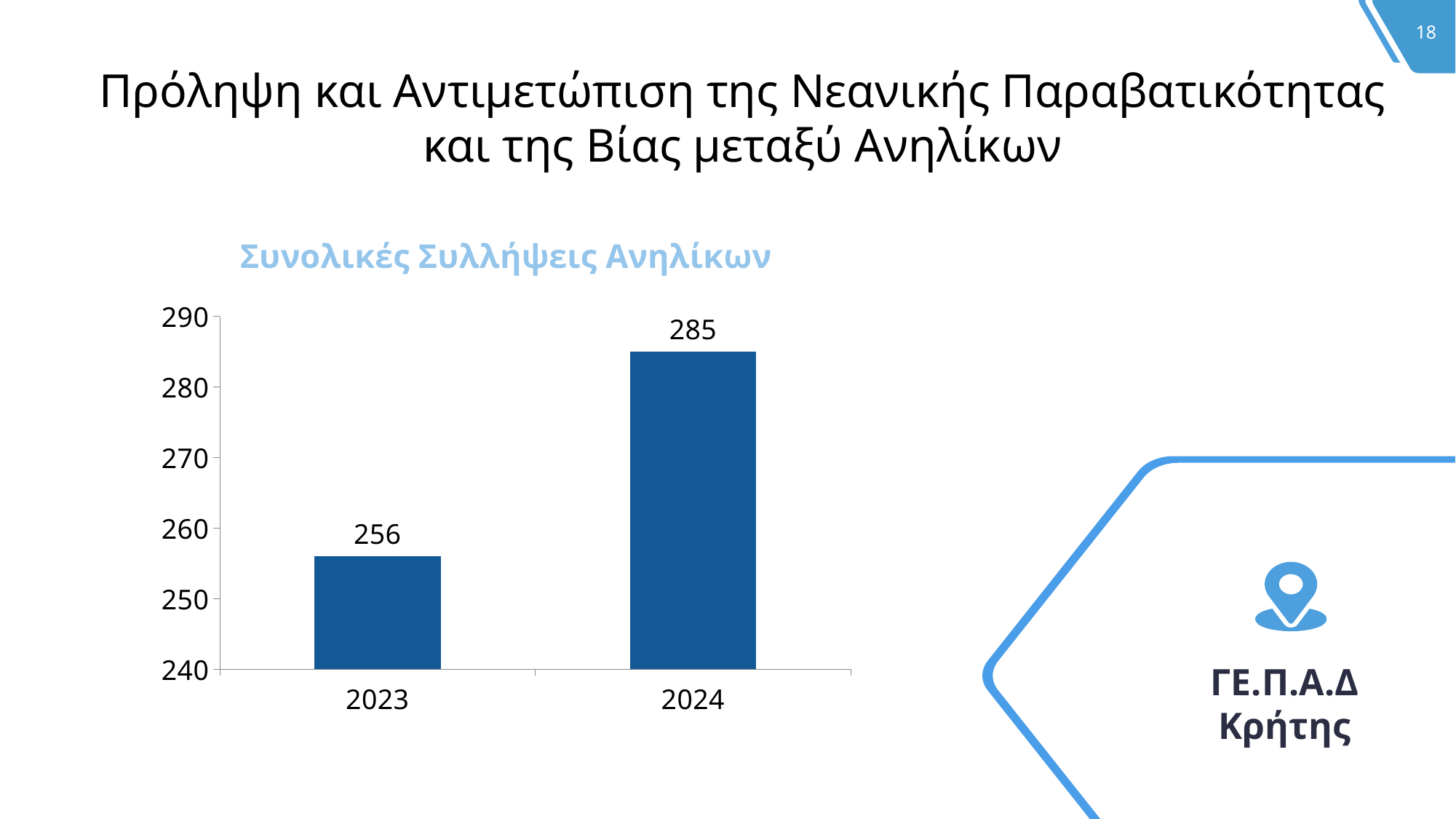
What is the value for 2024? 285 What is the difference between the values for 2024 and 2023? 29 What is the title of the chart? Συνολικές Συλλήψεις Ανηλίκων What kind of chart is shown on the slide? bar chart Is the value for 2024 greater or less than 280? greater Is the value for 2023 greater or less than 260? less Which year has the highest value? 2024 Which year has the lowest value? 2023 How many categories are shown on the x axis? 2 Which is larger, the value for 2023 or the value for 2024? 2024 Do the values rise or fall from 2023 to 2024? rise What is the value for 2023? 256